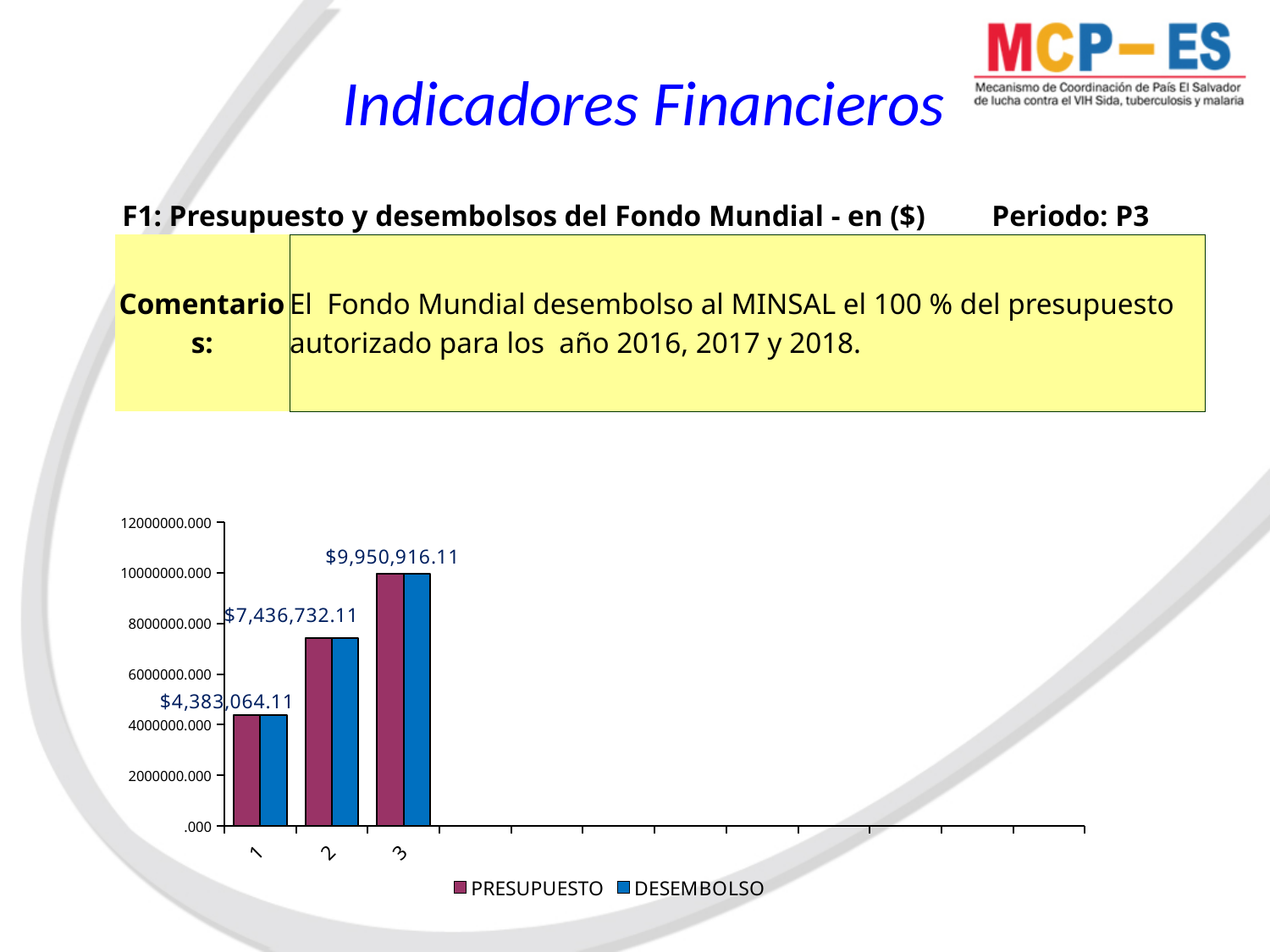
What value is labelled for category 1 in the chart? $4,383,064.11 Which category has the lowest labelled value in the chart? 1 What kind of chart is shown on the slide? Bar chart Which category has the highest labelled value in the chart? 3 What is the difference between the labelled values for category 3 and category 2? $2,514,184.00 How many series does the legend list? 2 Which is larger, the labelled value for category 2 or for category 1? Category 2 Do the values rise or fall from category 1 to category 3? Rise What is the difference between the labelled values for category 2 and category 1? $3,053,668.00 What value is labelled for category 3 in the chart? $9,950,916.11 Is the value for category 1 greater or less than 6000000.000? less What value is labelled for category 2 in the chart? $7,436,732.11